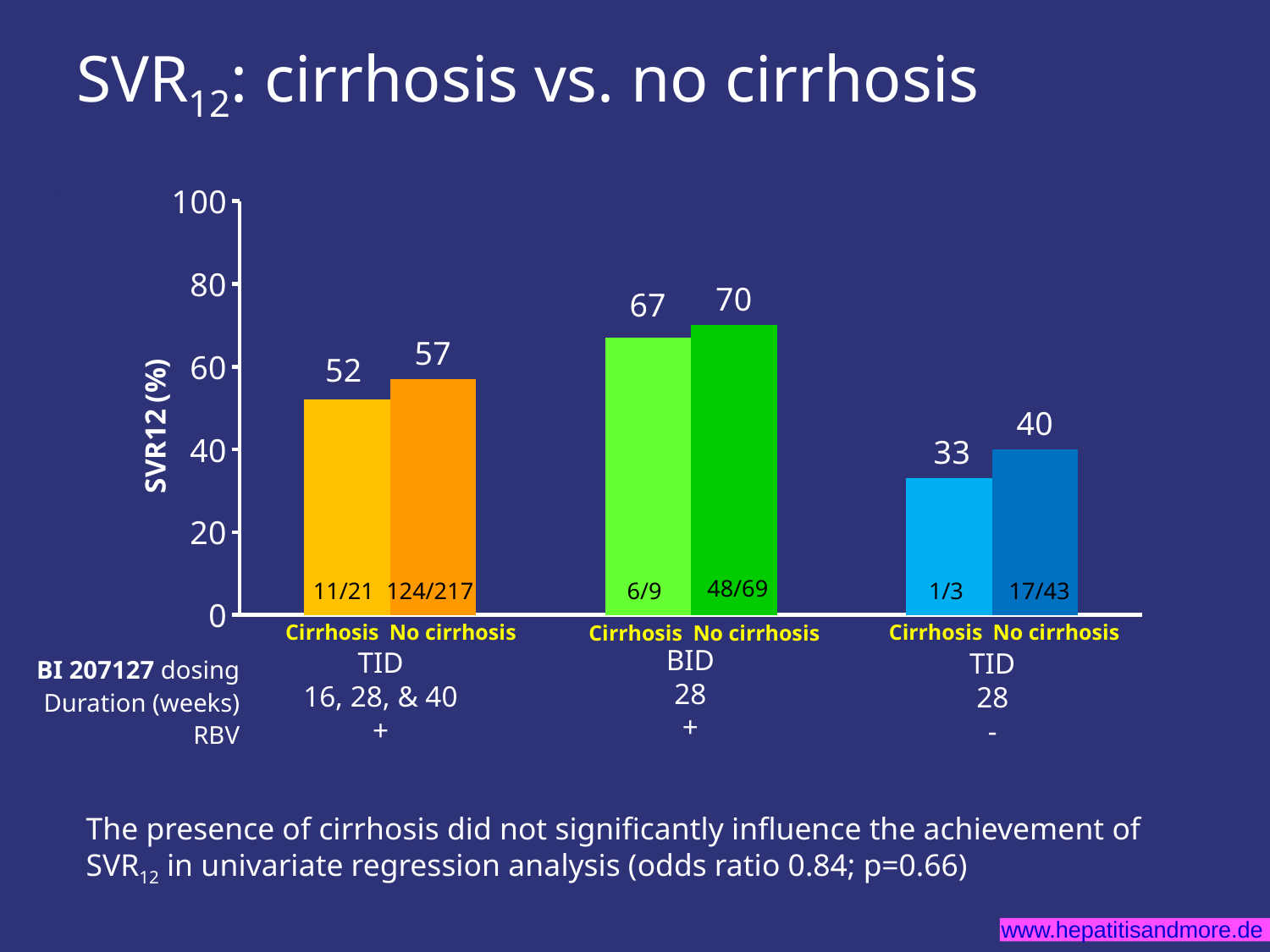
What is the SVR12 (%) value for the Cirrhosis bar in the TID 28 weeks (no RBV) group? 33 Which bar has the highest SVR12 (%) value on the chart? No cirrhosis, BID 28 weeks (70) What is the difference in SVR12 (%) between the No cirrhosis and Cirrhosis bars in the TID 28 weeks (no RBV) group? 7 What is the SVR12 (%) value for the No cirrhosis bar in the BID 28 weeks group? 70 What is the label of the y axis? SVR12 (%) How many bars are plotted on the chart? 6 What kind of chart is shown on the slide? Bar chart What is the SVR12 (%) value for the Cirrhosis bar in the TID 16, 28, & 40 weeks group? 52 What fraction of patients is printed on the No cirrhosis bar in the TID 16, 28, & 40 weeks group? 124/217 Which is larger: the Cirrhosis value in the BID 28 weeks group or the No cirrhosis value in the TID 16, 28, & 40 weeks group? Cirrhosis in the BID 28 weeks group (67) Is the SVR12 (%) value for the No cirrhosis bar in the BID 28 weeks group greater or less than 60? greater Which bar has the lowest SVR12 (%) value on the chart? Cirrhosis, TID 28 weeks (33)